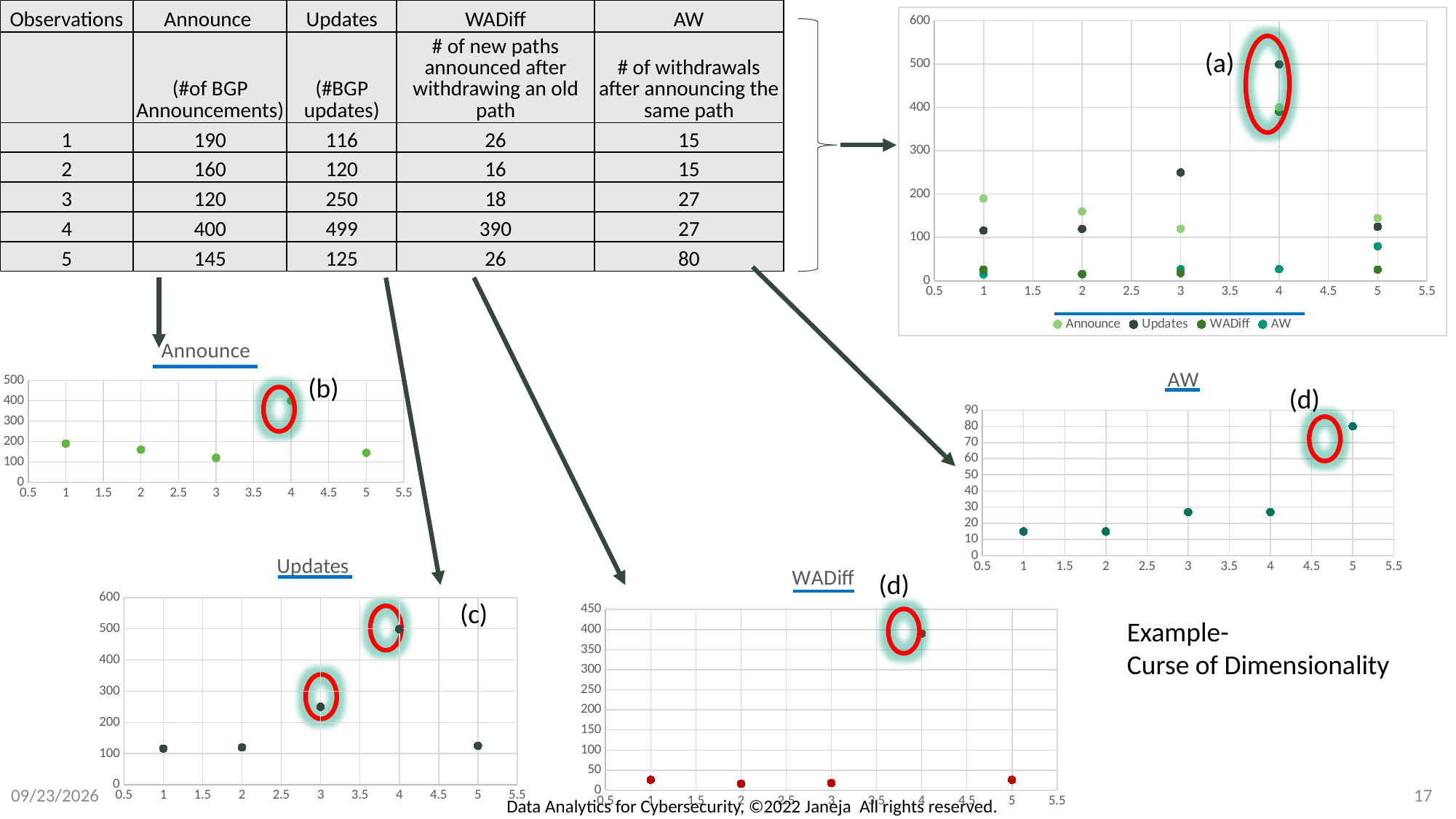
In the 'Announce' chart, which observation has the highest value? 4 What is the title of the chart in the bottom-left area of the slide, below the 'Announce' chart? Updates In the 'AW' chart, is the value for observation 1 greater or less than 20? less In the 'AW' chart, which observation has the highest value? 5 In the 'WADiff' chart, is the value for observation 4 greater or less than 350? greater In the 'Updates' chart, which is larger: the value for observation 4 or the value for observation 3? observation 4 In the 'Announce' chart, is the value for observation 3 greater or less than 200? less What kind of chart is the 'Announce' chart on the slide? scatter chart In the 'Updates' chart, which observation has the lowest value? 1 How many series does the legend of the top-right combined chart list? 4 How many data points are plotted in the 'Updates' chart? 5 In the 'Updates' chart, is the value for observation 3 greater or less than 200? greater